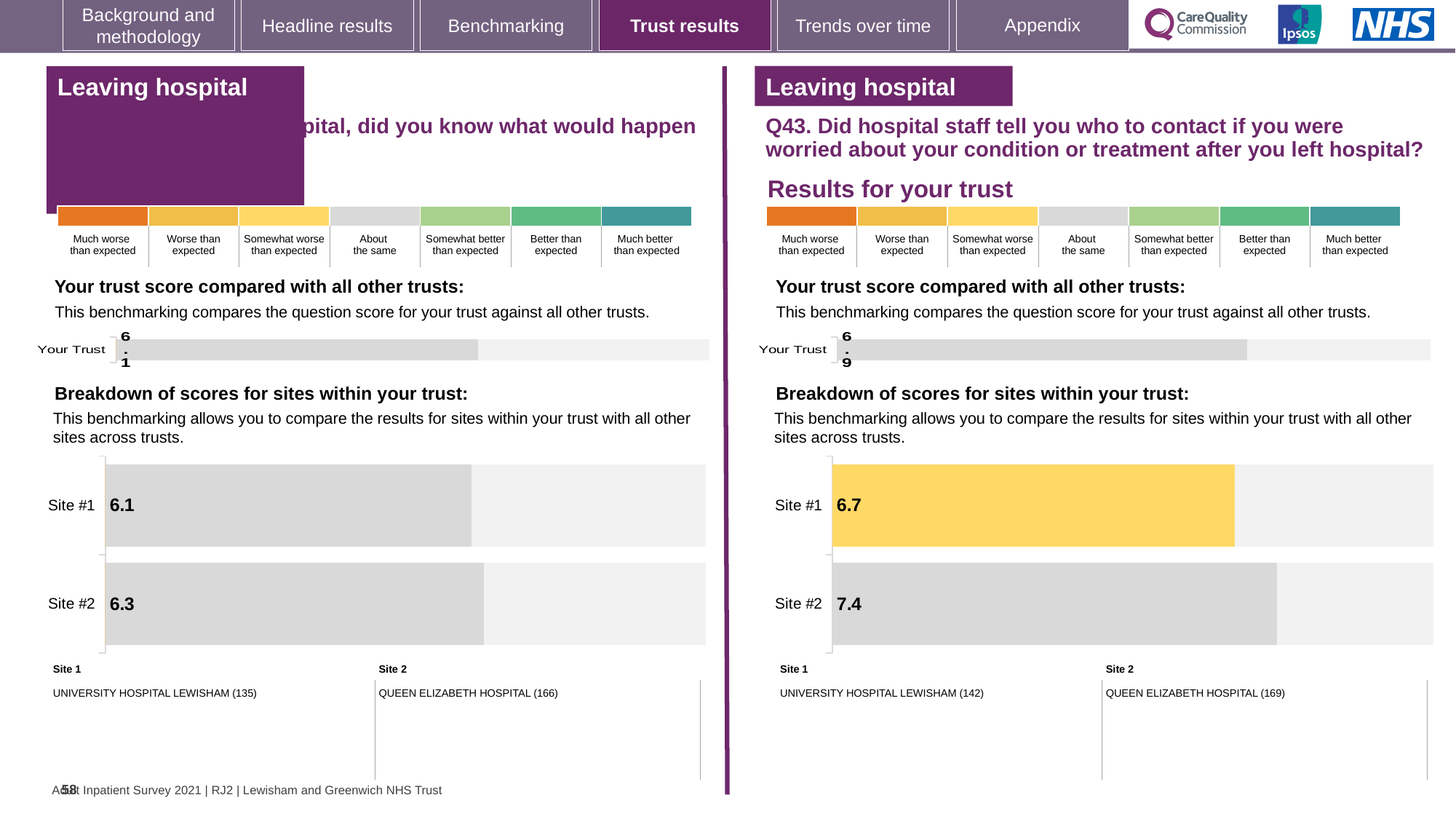
What type of chart is used for the site breakdown on the right panel? Bar chart In the site breakdown chart on the left panel, what is the score for Site #2? 6.3 In the Q43 'Your trust score compared with all other trusts' chart on the right, what is the score shown for Your Trust? 6.9 How many sites are shown in the Q43 site breakdown chart on the right? 2 In the site breakdown chart on the left panel, what is the difference between the Site #2 and Site #1 scores? 0.2 In the site breakdown chart on the left panel, which site has the lower score? Site #1 In the 'Your trust score compared with all other trusts' chart on the left panel, what is the score shown for Your Trust? 6.1 In the site breakdown chart on the left panel, what is the score for Site #1? 6.1 In the Q43 site breakdown chart on the right, which site has the higher score? Site #2 In the Q43 site breakdown chart on the right, what is the score for Site #2? 7.4 In the Q43 site breakdown chart on the right, what is the difference between the Site #2 and Site #1 scores? 0.7 In the Q43 site breakdown chart on the right, what is the score for Site #1? 6.7